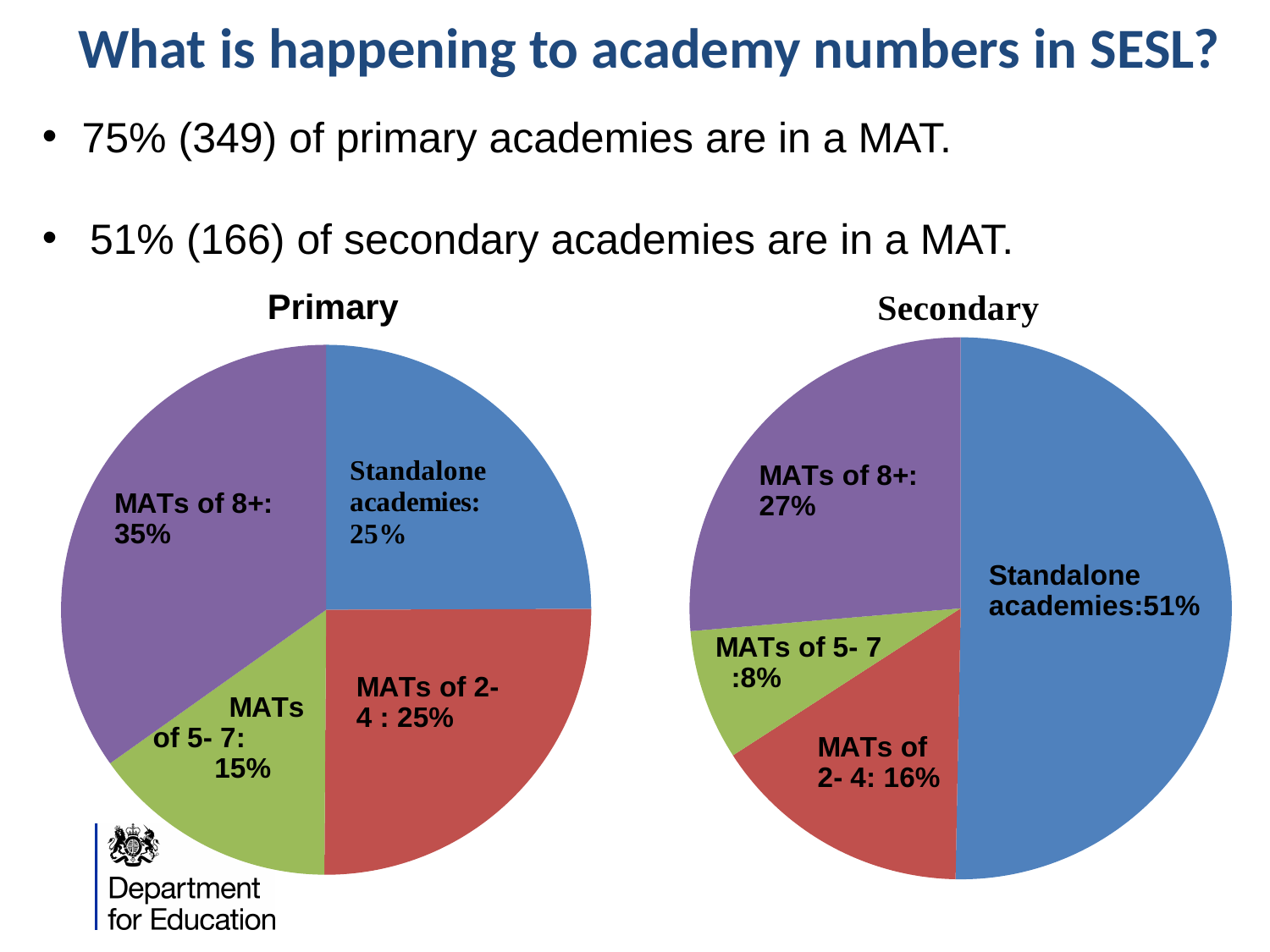
In the Secondary pie chart, what share do standalone academies have? 51% In the Secondary pie chart, what is the difference between the share of standalone academies and the share of MATs of 8+? 24% In the Secondary pie chart, which category has the smallest share? MATs of 5-7 How many slices does the Secondary pie chart have? 4 In the Primary pie chart, which is larger: the share of MATs of 2-4 or the share of MATs of 5-7? MATs of 2-4 In the Primary pie chart, what share do MATs of 8+ have? 35% In the Primary pie chart, which category has the largest share? MATs of 8+ In the Secondary pie chart, what share do MATs of 2-4 have? 16% What colour is the standalone academies slice in the Secondary pie chart? Blue What type of chart is the Primary chart? Pie chart In the Primary pie chart, what share do MATs of 5-7 have? 15% In the Primary pie chart, what is the combined share of MATs of 2-4 and MATs of 5-7? 40%